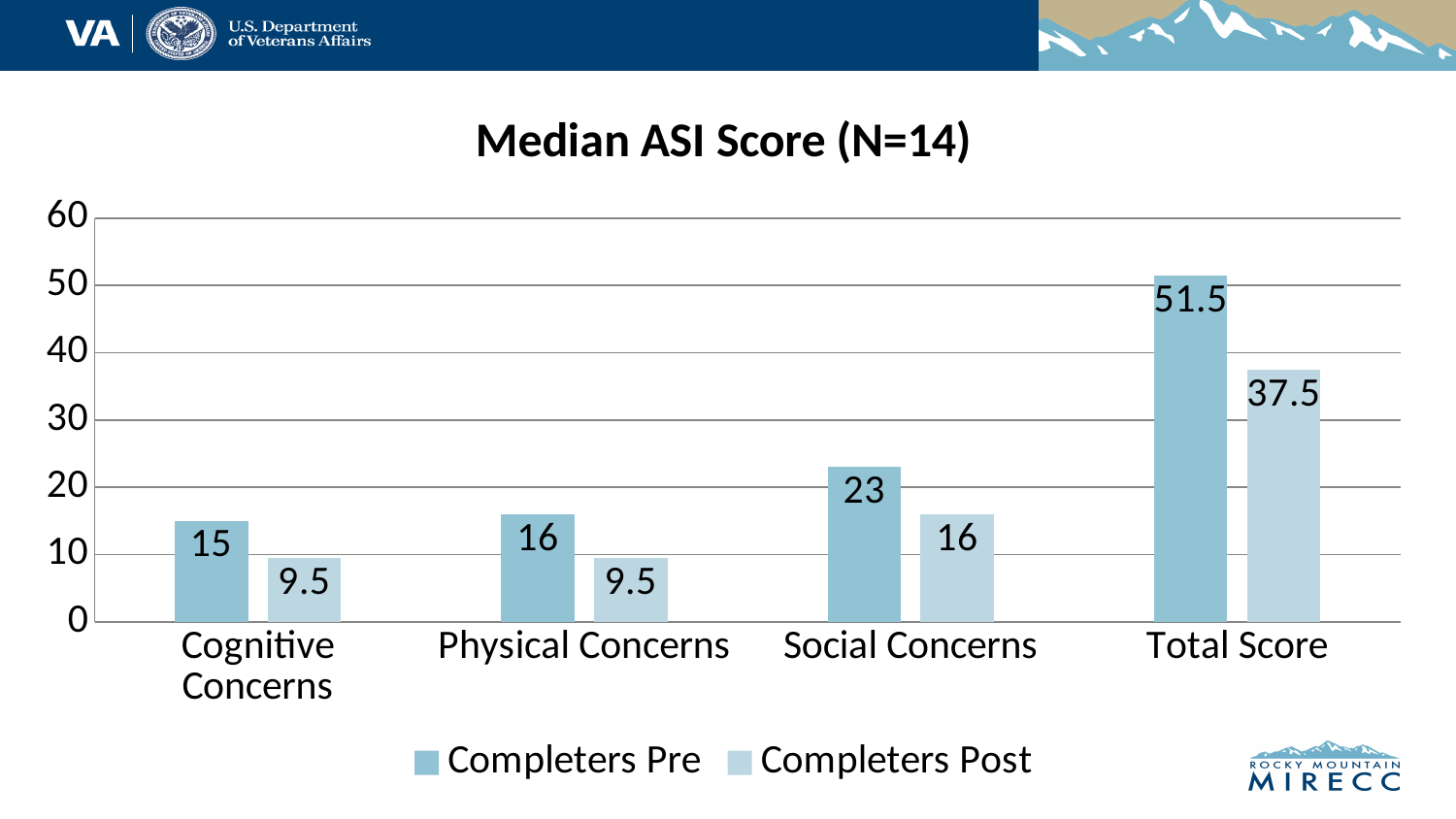
Which category has the lowest Completers Pre value? Cognitive Concerns What is the Completers Post value for Cognitive Concerns? 9.5 Which category has the highest Completers Pre value? Total Score How many series does the legend list? 2 Which is larger: the Completers Pre value for Physical Concerns or the Completers Post value for Social Concerns? Neither; they are equal (both 16) What is the difference between the Completers Pre and Completers Post values for Social Concerns? 7 What kind of chart is shown on the slide? Bar chart What is the Completers Post value for Total Score? 37.5 What is the Completers Pre value for Social Concerns? 23 How many categories are shown on the x axis? 4 Is the Completers Pre value for Total Score greater or less than 50? greater What is the difference between the Completers Pre and Completers Post values for Total Score? 14